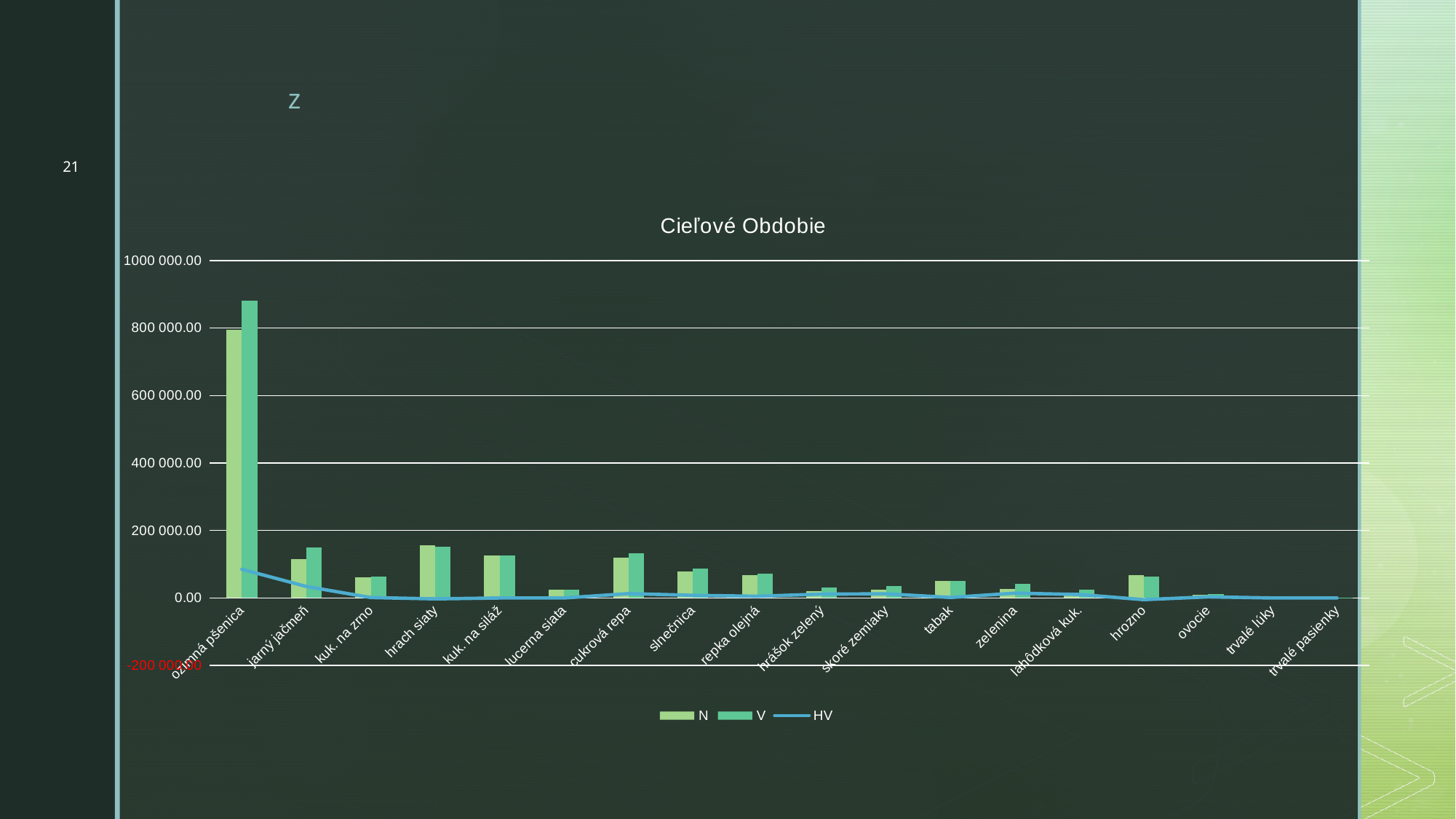
What are the names of the series in the legend? N, V, HV What is the title of the chart? Cieľové Obdobie How many categories are shown on the x axis? 18 Is the value of series N for ozimná pšenica greater or less than 600 000.00? greater Is the value of series V for jarný jačmeň greater or less than 200 000.00? less Is the value of series V for ozimná pšenica greater or less than 800 000.00? greater What kind of chart is this? Bar chart with a line series For ozimná pšenica, which series has the larger value, N or V? V Which category has the highest value for series N? ozimná pšenica Does the HV line rise or fall from ozimná pšenica to kuk. na zrno? fall Which category has the highest value for series V? ozimná pšenica How many series does the legend list? 3